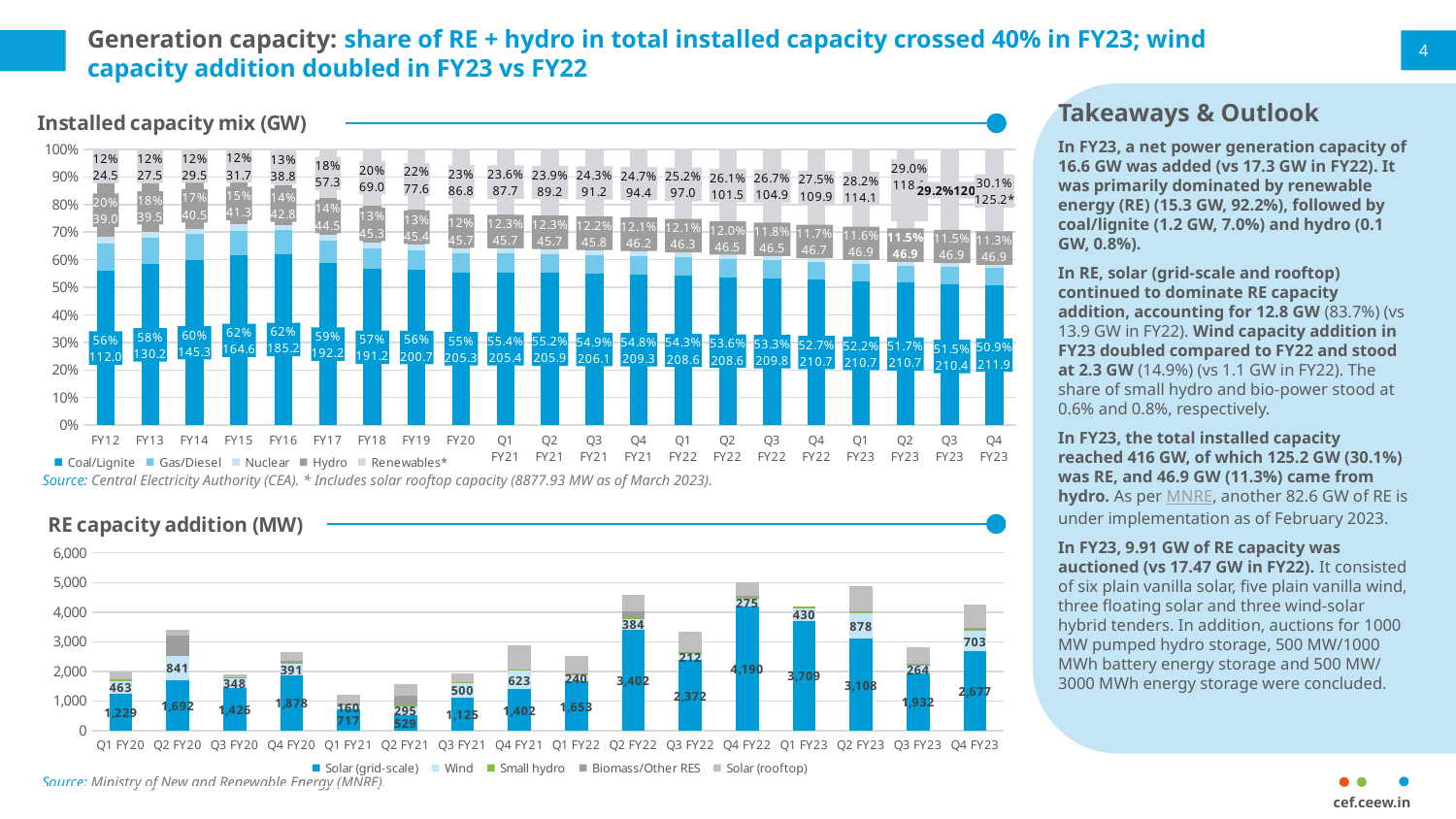
In the 'RE capacity addition (MW)' chart, which is larger: the Wind addition in Q2 FY20 or in Q4 FY23? Q2 FY20 In the 'Installed capacity mix (GW)' chart, how many series does the legend list? 5 In the 'RE capacity addition (MW)' chart, what is the difference between the Solar (grid-scale) addition in Q4 FY22 and in Q1 FY23? 481 In the 'RE capacity addition (MW)' chart, what is the Wind addition in Q2 FY23? 878 In the 'Installed capacity mix (GW)' chart, does the Coal/Lignite share rise or fall from FY16 to Q4 FY23? Fall In the 'Installed capacity mix (GW)' chart, what is the Coal/Lignite share in Q4 FY23? 50.9% In the 'RE capacity addition (MW)' chart, how many quarters are shown on the x axis? 16 What kind of chart is the 'Installed capacity mix (GW)' chart? Stacked bar chart In the 'RE capacity addition (MW)' chart, which quarter has the lowest Solar (grid-scale) addition? Q2 FY21 In the 'Installed capacity mix (GW)' chart, what is the Coal/Lignite capacity in GW in FY15? 164.6 In the 'Installed capacity mix (GW)' chart, what is the Renewables share in FY12? 12% In the 'RE capacity addition (MW)' chart, which quarter has the highest Solar (grid-scale) addition? Q4 FY22